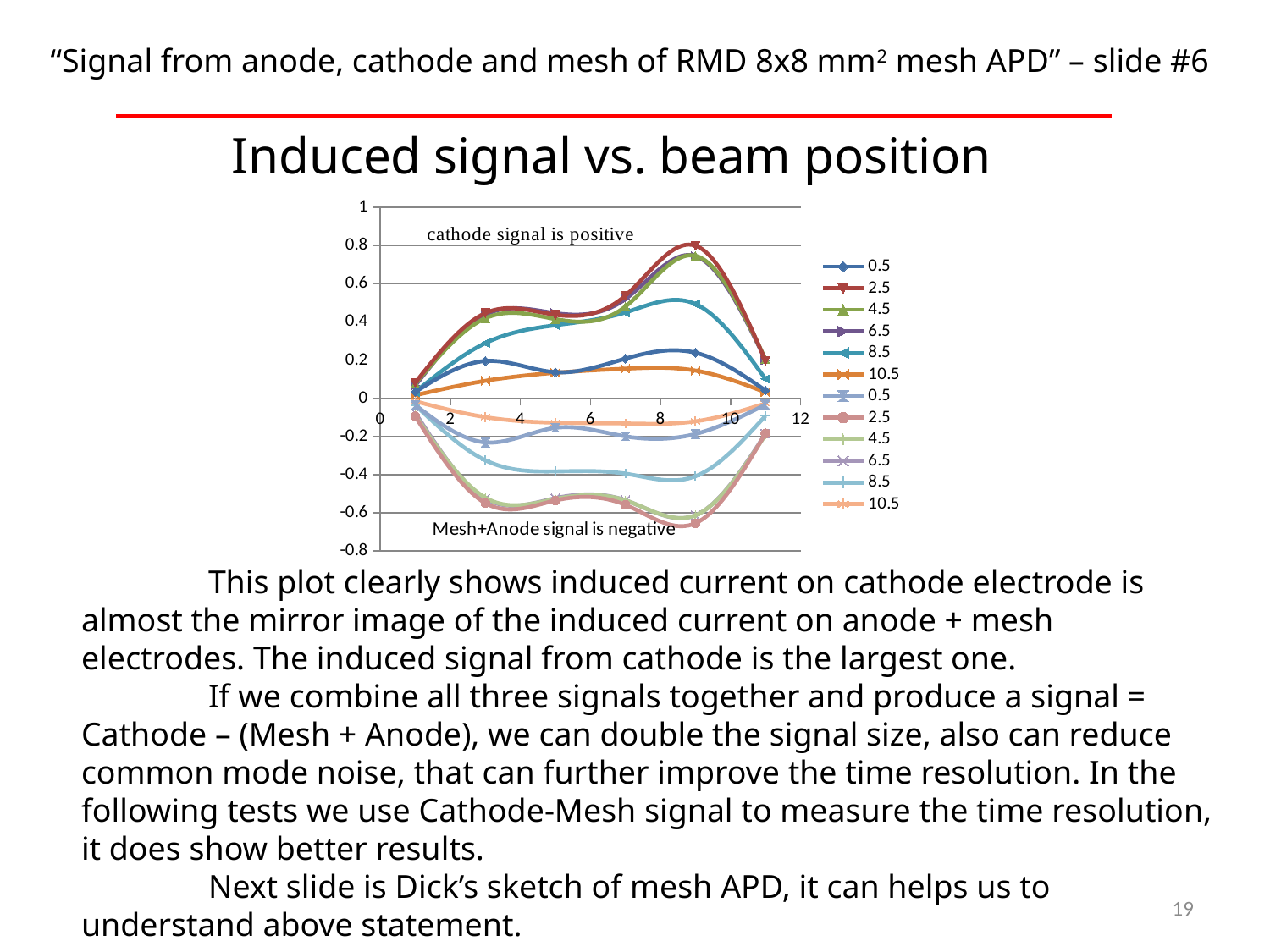
Is the lowest point plotted on the chart greater or less than -0.8? greater Do the positive (cathode) curves rise or fall between x = 10 and x = 11? fall How many legend entries are labelled 10.5? 2 Is the lowest point plotted on the chart greater or less than -0.4? less Is the highest point plotted on the chart greater or less than 0.6? greater What is the title of the chart? Induced signal vs. beam position What kind of chart is shown on the slide? line chart What annotation is written in the upper part of the plot area? cathode signal is positive Do the negative (mesh+anode) curves rise or fall between x = 10 and x = 11? rise How many series does the chart's legend list? 12